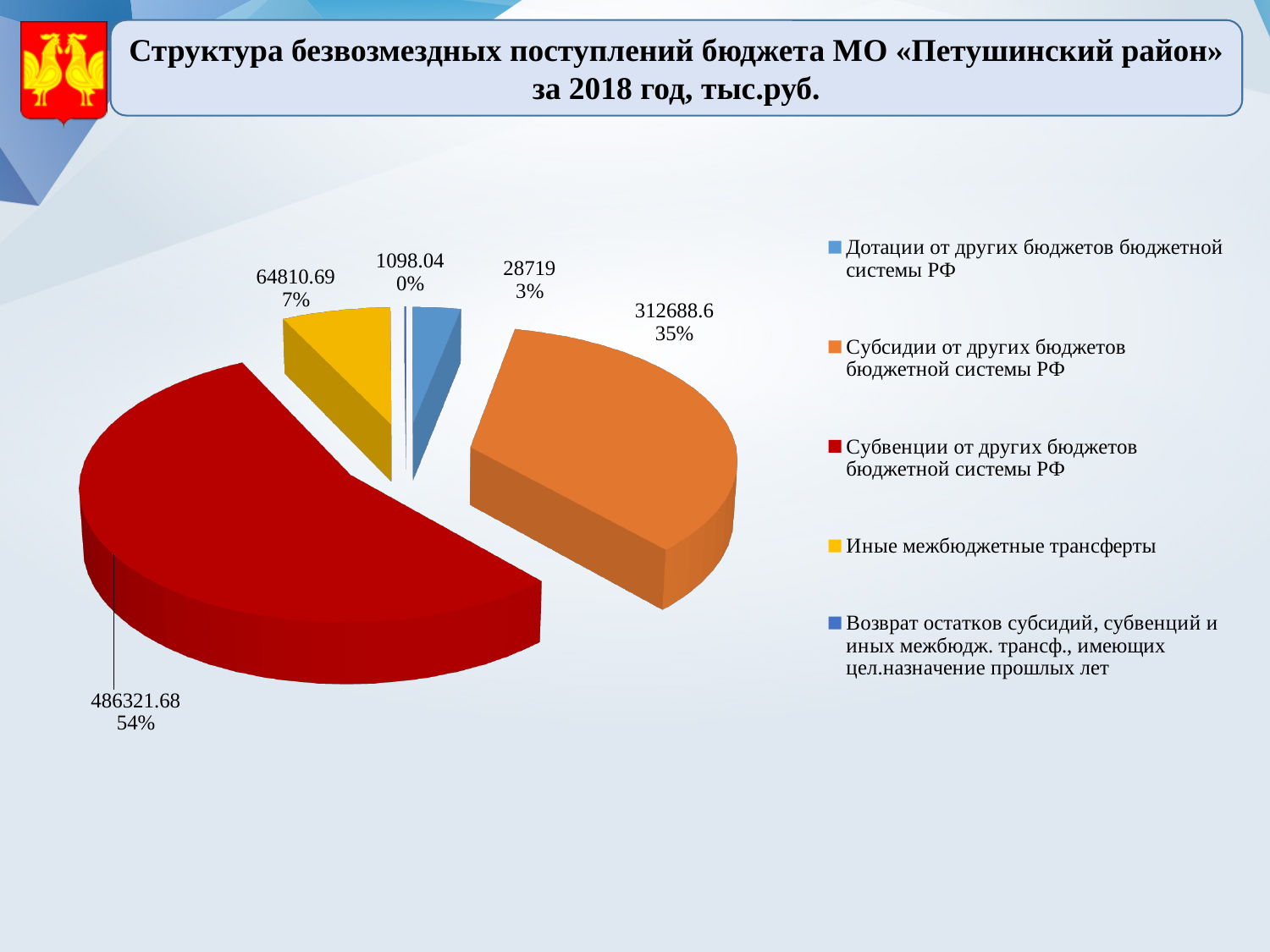
What is the value for Дотации от других бюджетов бюджетной системы РФ? 28719 How many entries does the legend list? 5 What is the difference between the values for Субвенции and Субсидии от других бюджетов бюджетной системы РФ? 173633.08 Which category has the smallest slice? Возврат остатков субсидий, субвенций и иных межбюдж. трансф., имеющих цел.назначение прошлых лет How many slices does the pie chart have? 5 What kind of chart is shown on the slide? pie chart What is the value for Субсидии от других бюджетов бюджетной системы РФ? 312688.6 What is the value for Иные межбюджетные трансферты? 64810.69 What is the value for Субвенции от других бюджетов бюджетной системы РФ? 486321.68 What share of the pie does Субвенции от других бюджетов бюджетной системы РФ represent? 54% What share of the pie does Иные межбюджетные трансферты represent? 7% Which category has the largest slice? Субвенции от других бюджетов бюджетной системы РФ